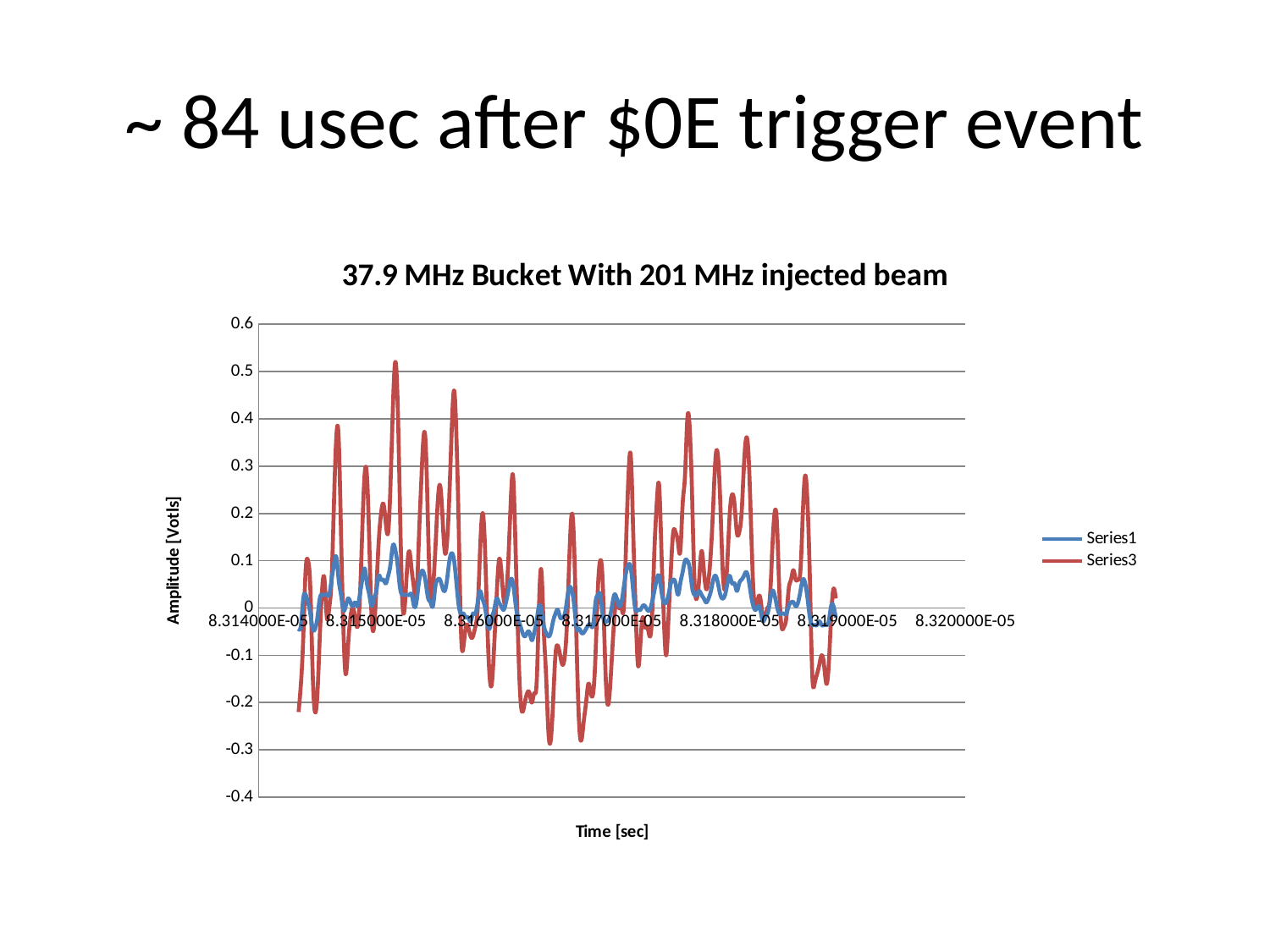
Is the highest value reached by Series1 greater or less than 0.2? less Is the lowest value reached by Series1 greater or less than -0.2? greater Which series reaches the lowest value on the chart? Series3 Which series shows larger swings in amplitude, Series1 or Series3? Series3 What is the highest value shown on the vertical axis? 0.6 What kind of chart is shown on the slide? line chart What is the label of the vertical axis? Amplitude [Votls] Is the highest value reached by Series3 greater or less than 0.4? greater What is the title of the chart? 37.9 MHz Bucket With 201 MHz injected beam Which series reaches the highest value on the chart? Series3 How many series does the legend list? 2